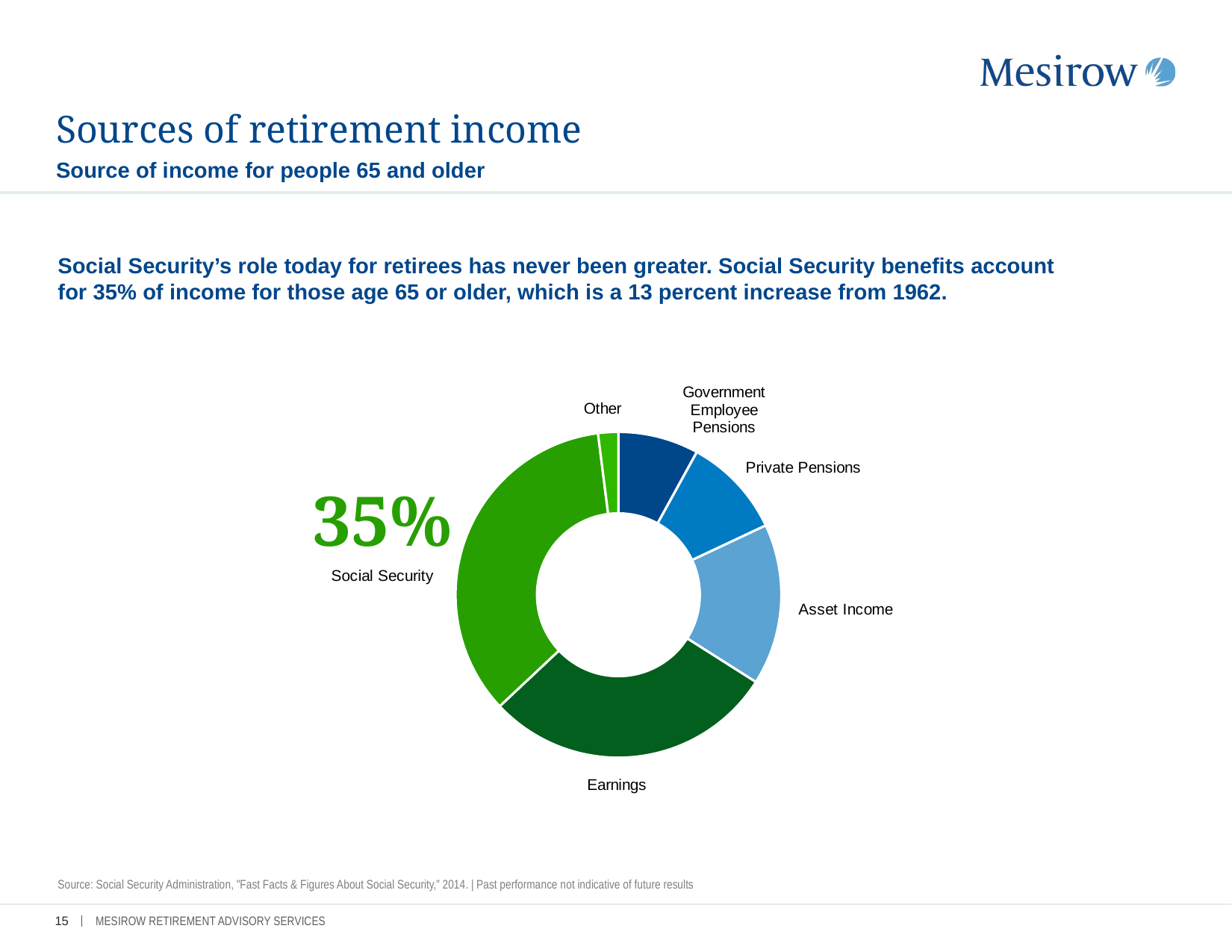
Which is the larger slice, Other or Government Employee Pensions? Government Employee Pensions Which is the larger slice, Earnings or Asset Income? Earnings Which is the larger slice, Social Security or Earnings? Social Security Which income source is the smallest slice of the chart? Other Which slice of the chart is labelled with a large percentage value? Social Security Which income source is the largest slice of the chart? Social Security What is the title of the slide containing the chart? Sources of retirement income What kind of chart is shown on the slide? doughnut chart How many income sources are shown in the chart? 6 What share of income for people 65 and older comes from Social Security? 35%